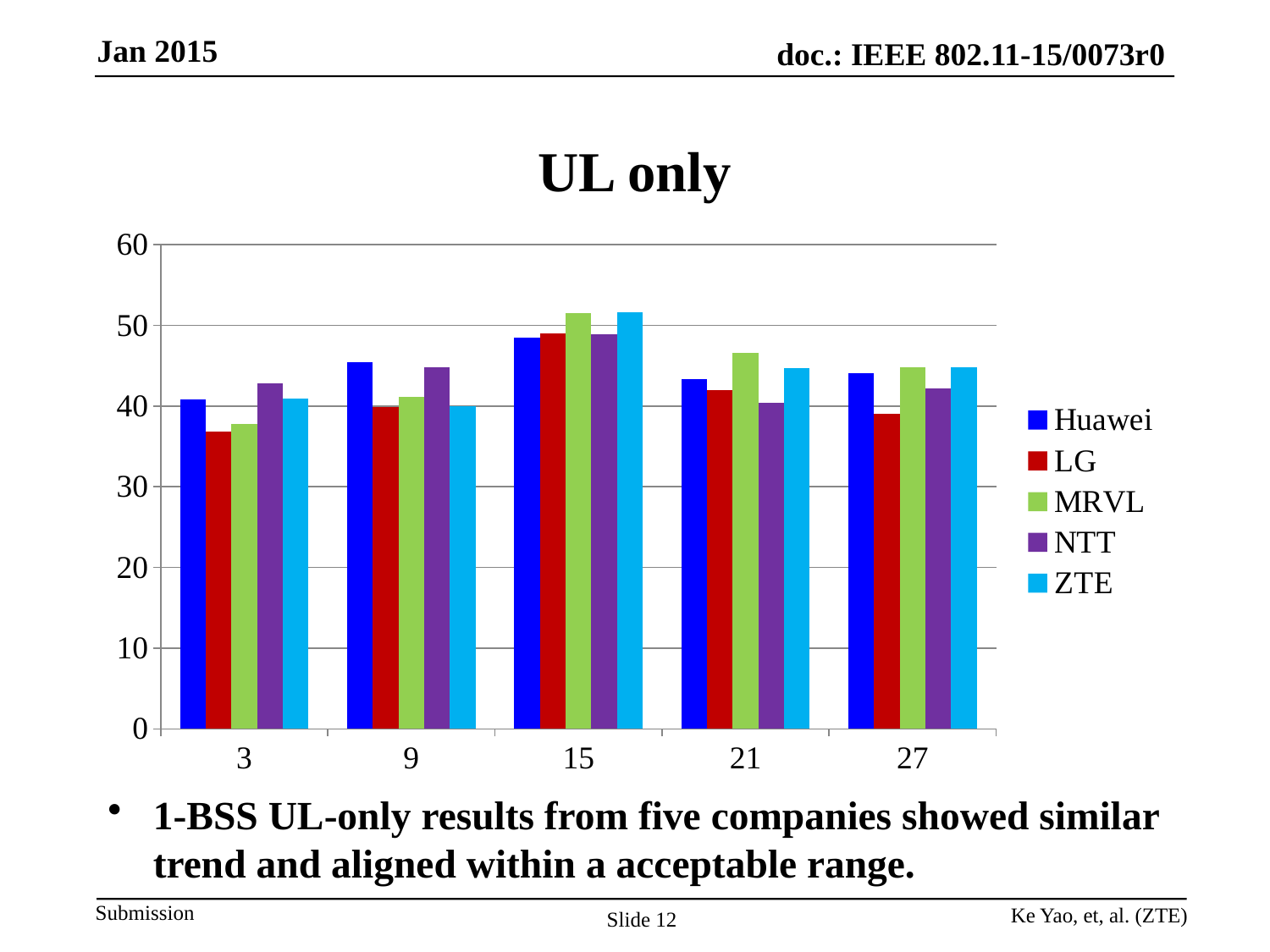
Is the value for LG at category 27 greater or less than 40? less Is the value for LG at category 3 greater or less than 40? less At category 21, which series has the highest bar? MRVL Is the value for Huawei at category 9 greater or less than 40? greater For the Huawei series, which category has the highest bar? 15 At category 9, which is larger, Huawei or LG? Huawei What kind of chart is shown on the slide? bar chart How many series does the legend list? 5 At category 27, which series has the lowest bar? LG How many categories are shown on the x axis? 5 What is the title of the chart? UL only